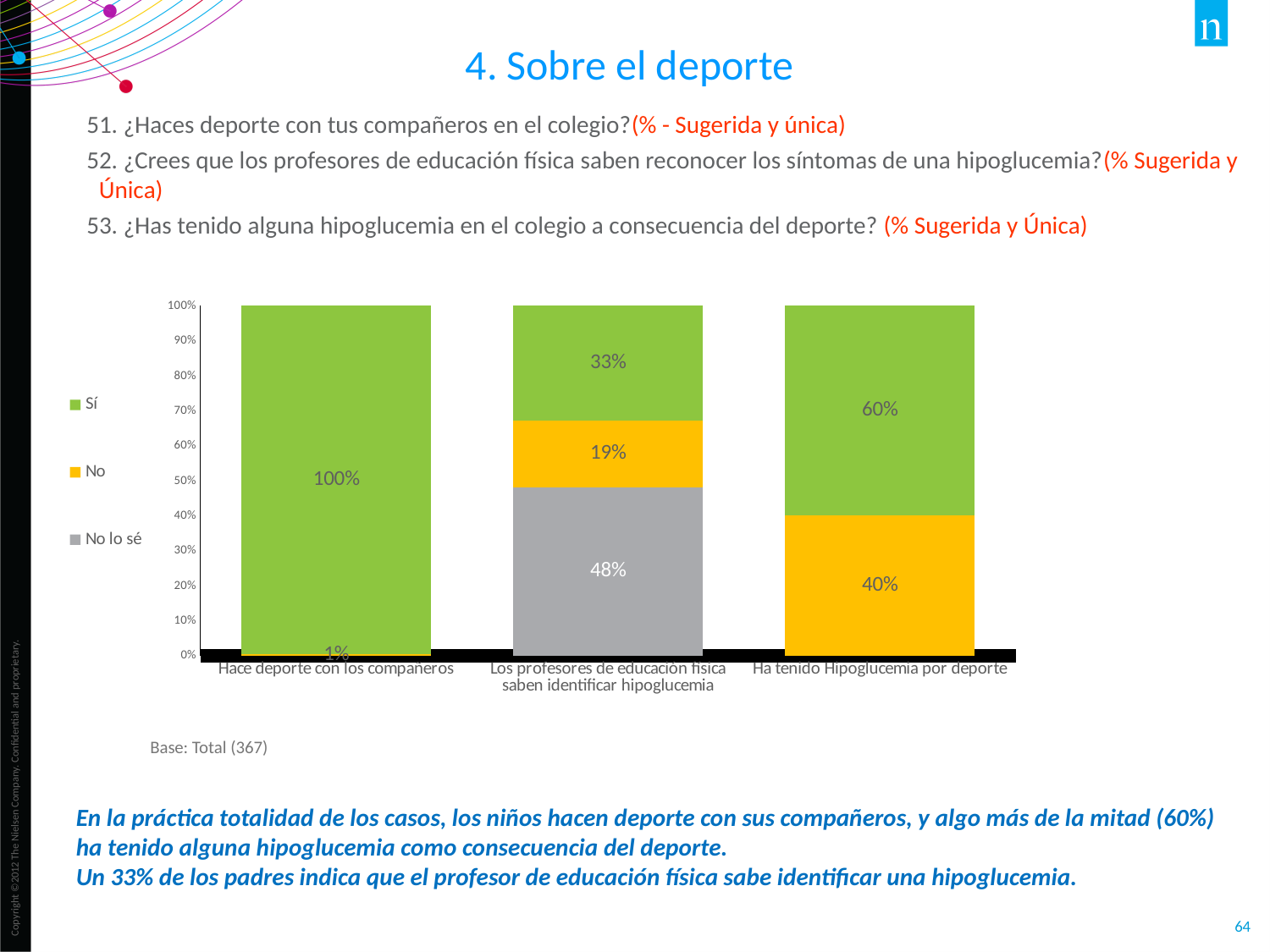
What percentage answered "No" for "Los profesores de educación física saben identificar hipoglucemia"? 19% How many series does the chart legend list? 3 What percentage answered "No" for "Ha tenido Hipoglucemia por deporte"? 40% What is the difference between the "Sí" and "No" values for "Ha tenido Hipoglucemia por deporte"? 20% What kind of chart is shown on the slide? Stacked bar chart Which category has the lowest "Sí" value? Los profesores de educación física saben identificar hipoglucemia What percentage answered "No lo sé" for "Los profesores de educación física saben identificar hipoglucemia"? 48% What percentage of respondents answered "Sí" for "Ha tenido Hipoglucemia por deporte"? 60% Which category has the highest "Sí" value? Hace deporte con los compañeros How many categories are shown on the x axis of the chart? 3 For "Los profesores de educación física saben identificar hipoglucemia", which is larger: "Sí" or "No lo sé"? No lo sé What percentage answered "Sí" for "Hace deporte con los compañeros"? 100%